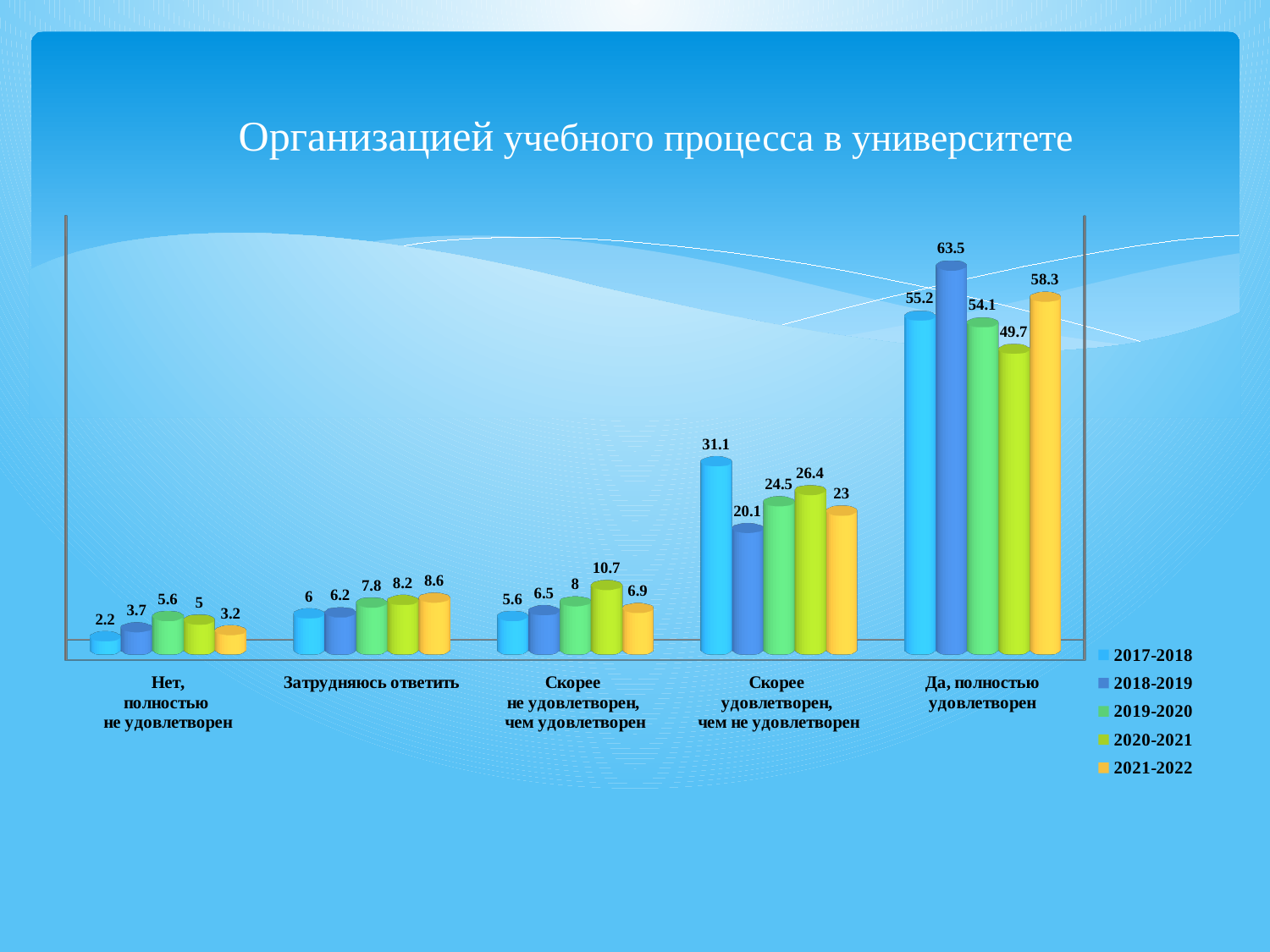
What kind of chart is shown on the slide? Bar chart What is the value for 2020-2021 in the category 'Скорее не удовлетворен, чем удовлетворен'? 10.7 What is the value for 2017-2018 in the category 'Нет, полностью не удовлетворен'? 2.2 How many series does the legend list? 5 What is the title of the chart? Организацией учебного процесса в университете What is the value for 2021-2022 in the category 'Скорее удовлетворен, чем не удовлетворен'? 23 What is the difference between the 2017-2018 and 2018-2019 values in the category 'Скорее удовлетворен, чем не удовлетворен'? 11 In the category 'Затрудняюсь ответить', which is larger: the value for 2017-2018 or for 2021-2022? 2021-2022 What is the value for 2018-2019 in the category 'Да, полностью удовлетворен'? 63.5 Which series has the highest value in the category 'Да, полностью удовлетворен'? 2018-2019 How many categories are shown on the x axis? 5 Which series has the lowest value in the category 'Скорее удовлетворен, чем не удовлетворен'? 2018-2019